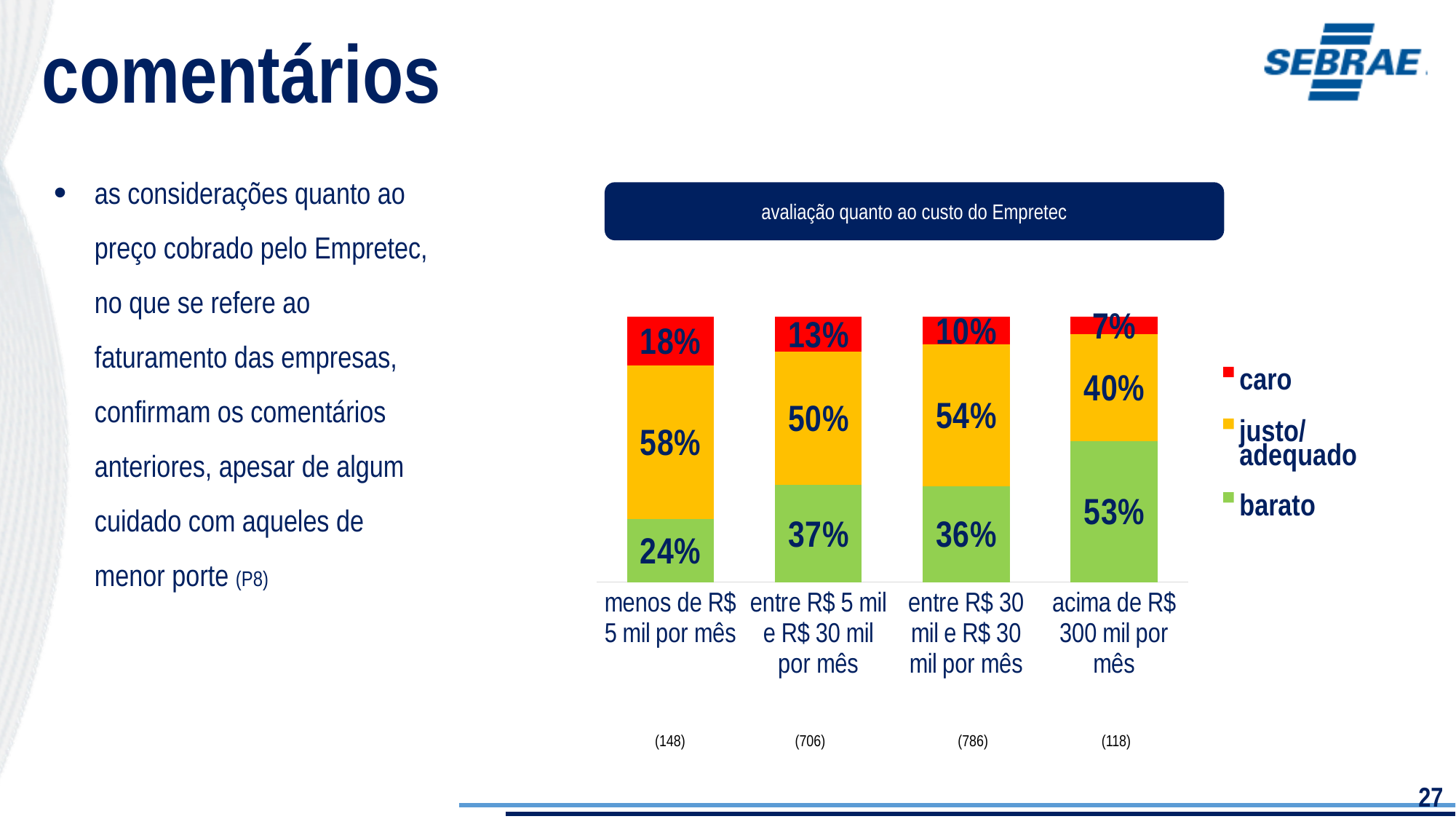
Which is larger: the 'justo/adequado' share for 'entre R$ 5 mil e R$ 30 mil por mês' or for 'acima de R$ 300 mil por mês'? entre R$ 5 mil e R$ 30 mil por mês What kind of chart is shown on the slide? Stacked bar chart What is the 'justo/adequado' value for the 'entre R$ 30 mil e R$ 30 mil por mês' category? 54% Which revenue category has the lowest 'barato' share? menos de R$ 5 mil por mês How many series does the chart legend list? 3 What is the 'barato' value for the 'acima de R$ 300 mil por mês' category? 53% What is the difference between the 'barato' share for 'acima de R$ 300 mil por mês' and for 'menos de R$ 5 mil por mês'? 29 percentage points Does the 'caro' share rise or fall as revenue increases from left to right along the x axis? Fall What is the title of the chart? avaliação quanto ao custo do Empretec How many revenue categories are shown on the x axis of the chart? 4 What percentage of respondents with revenue of 'menos de R$ 5 mil por mês' rated the Empretec cost as 'caro'? 18% Which revenue category has the highest 'caro' share? menos de R$ 5 mil por mês